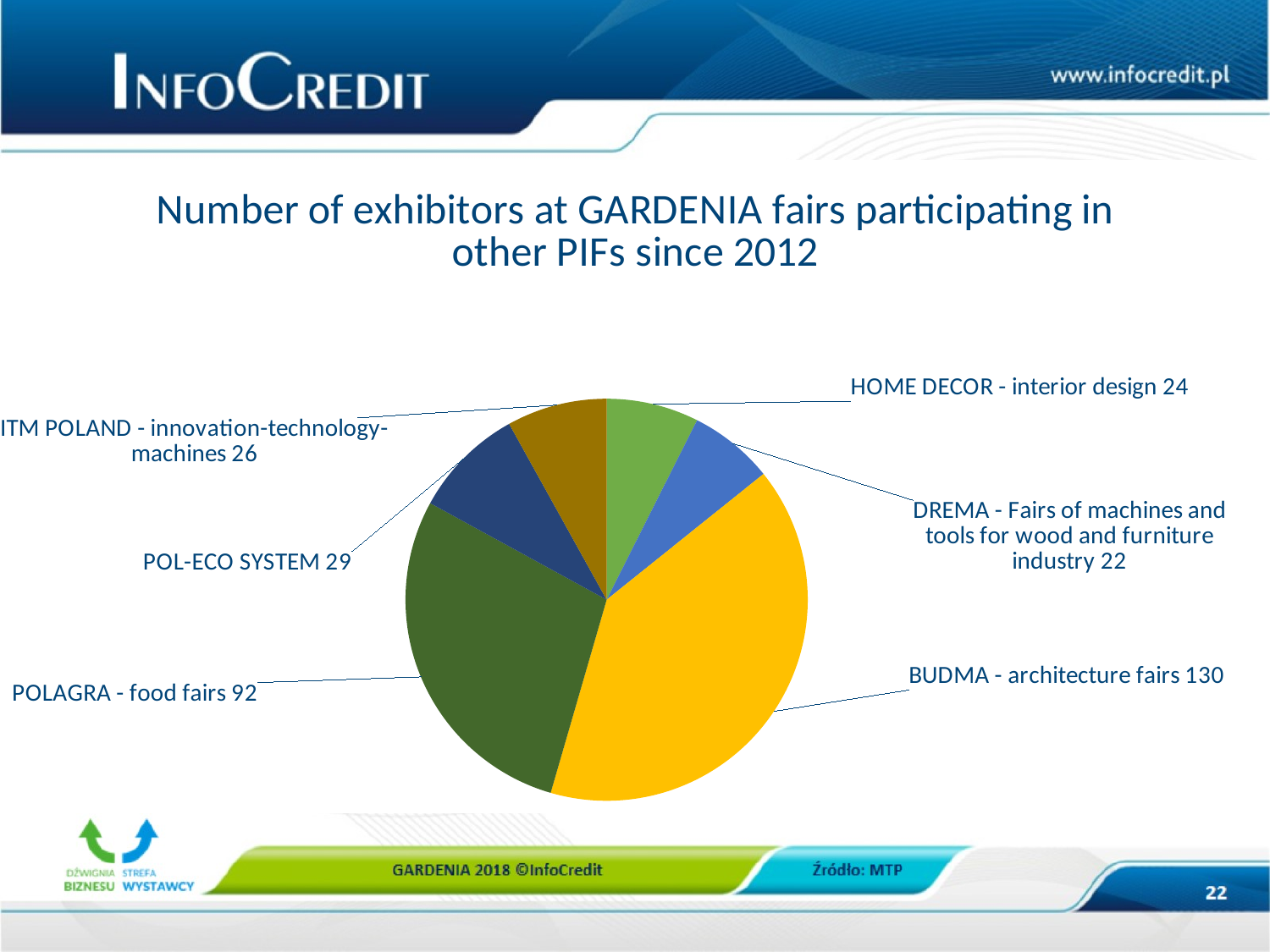
Which fair has the largest number of GARDENIA exhibitors? BUDMA - architecture fairs What is the value shown for DREMA - Fairs of machines and tools for wood and furniture industry? 22 What type of chart is shown on the slide? pie chart What is the value shown for POLAGRA - food fairs? 92 Which fair has the smallest number of GARDENIA exhibitors? DREMA - Fairs of machines and tools for wood and furniture industry What is the value shown for POL-ECO SYSTEM? 29 How many exhibitors at GARDENIA fairs participated in BUDMA - architecture fairs? 130 How many slices does the pie chart have? 6 What is the total number of exhibitors across all slices of the pie chart? 323 What is the title of the chart? Number of exhibitors at GARDENIA fairs participating in other PIFs since 2012 What is the difference between the values for BUDMA - architecture fairs and POLAGRA - food fairs? 38 Which has a higher value, POL-ECO SYSTEM or ITM POLAND - innovation-technology-machines? POL-ECO SYSTEM